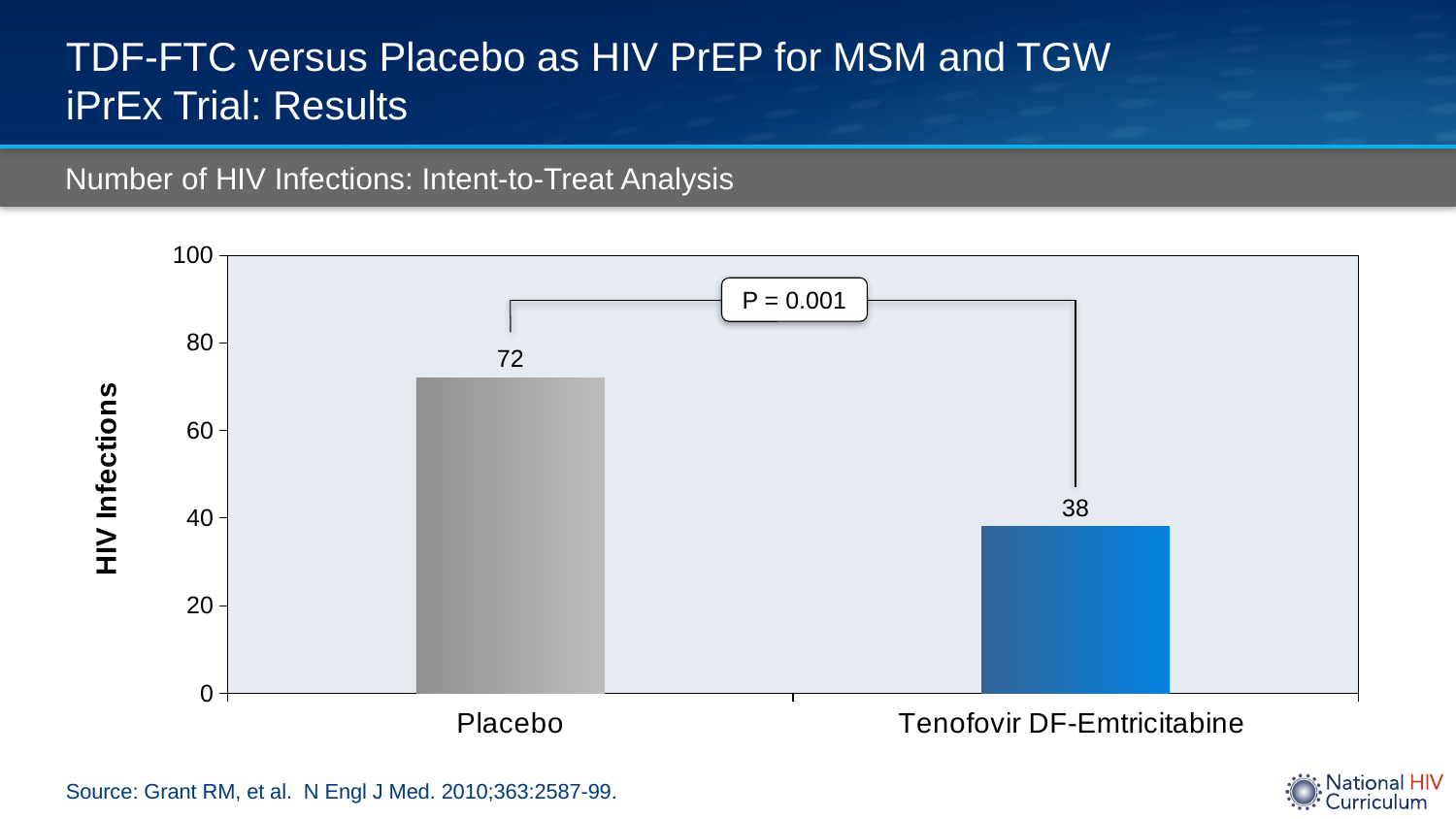
Is the value for Placebo greater or less than 60? greater Is the number of HIV infections larger for Placebo or for Tenofovir DF-Emtricitabine? Placebo What kind of chart is shown on the slide? Bar chart What is the difference in HIV infections between the Placebo and Tenofovir DF-Emtricitabine groups? 34 Which group has the higher number of HIV infections? Placebo Which group has the lower number of HIV infections? Tenofovir DF-Emtricitabine How many HIV infections are shown for the Placebo group? 72 How many groups are plotted on the chart? 2 What P value is shown on the chart? P = 0.001 What is the label of the y axis? HIV Infections How many HIV infections are shown for the Tenofovir DF-Emtricitabine group? 38 Is the value for Tenofovir DF-Emtricitabine greater or less than 40? less